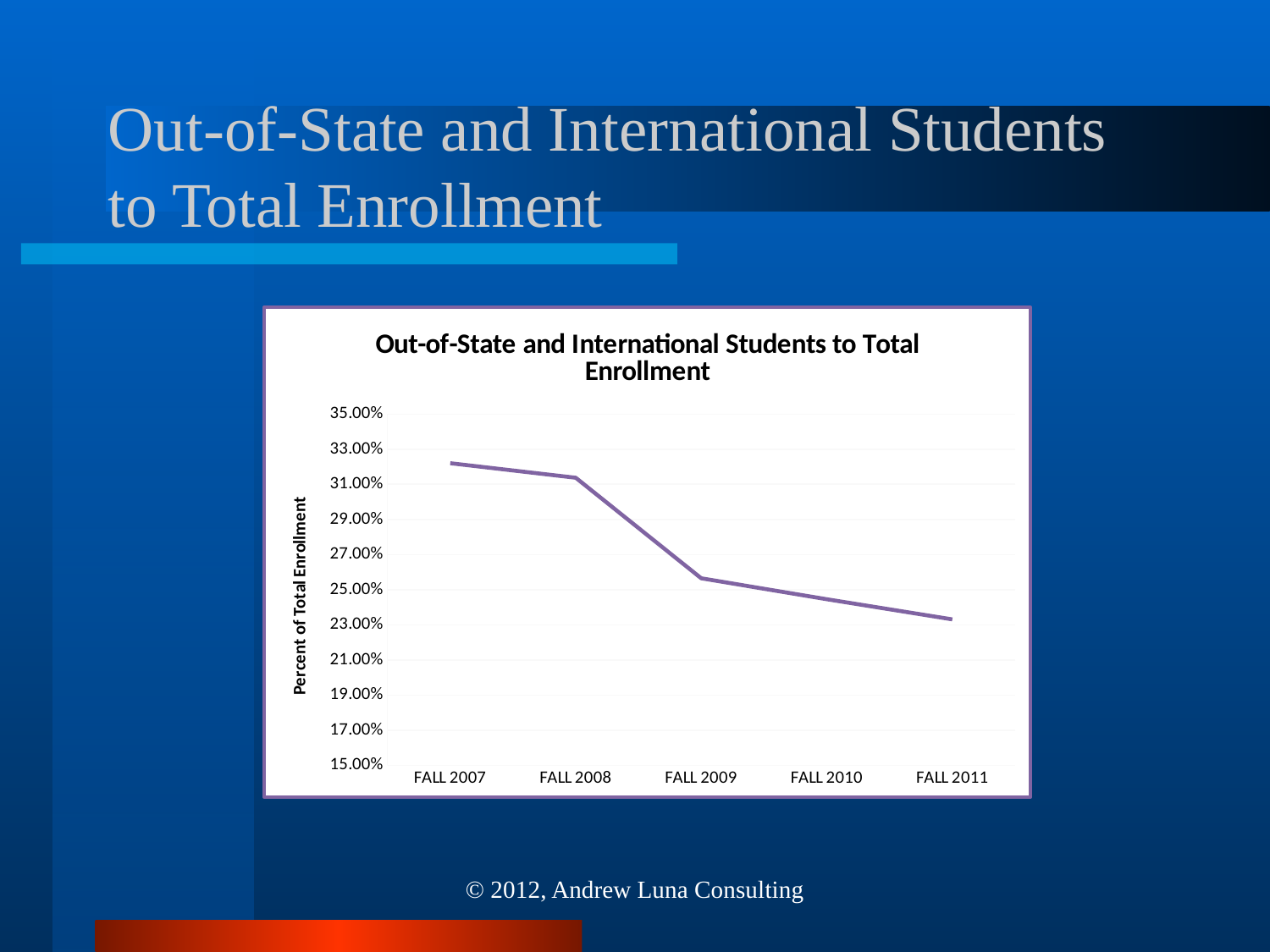
Is the value for FALL 2010 greater or less than 23.00%? greater What is the title of the chart? Out-of-State and International Students to Total Enrollment What kind of chart is shown on the slide? line chart Which term has the highest percent of total enrollment? FALL 2007 How many data points are plotted along the x axis? 5 Do the values rise or fall from FALL 2007 to FALL 2011? fall What is the label on the vertical axis of the chart? Percent of Total Enrollment Which term has the lowest percent of total enrollment? FALL 2011 Is the value for FALL 2009 greater or less than 27.00%? less Which is larger, the value for FALL 2008 or the value for FALL 2009? FALL 2008 Is the value for FALL 2007 greater or less than 31.00%? greater